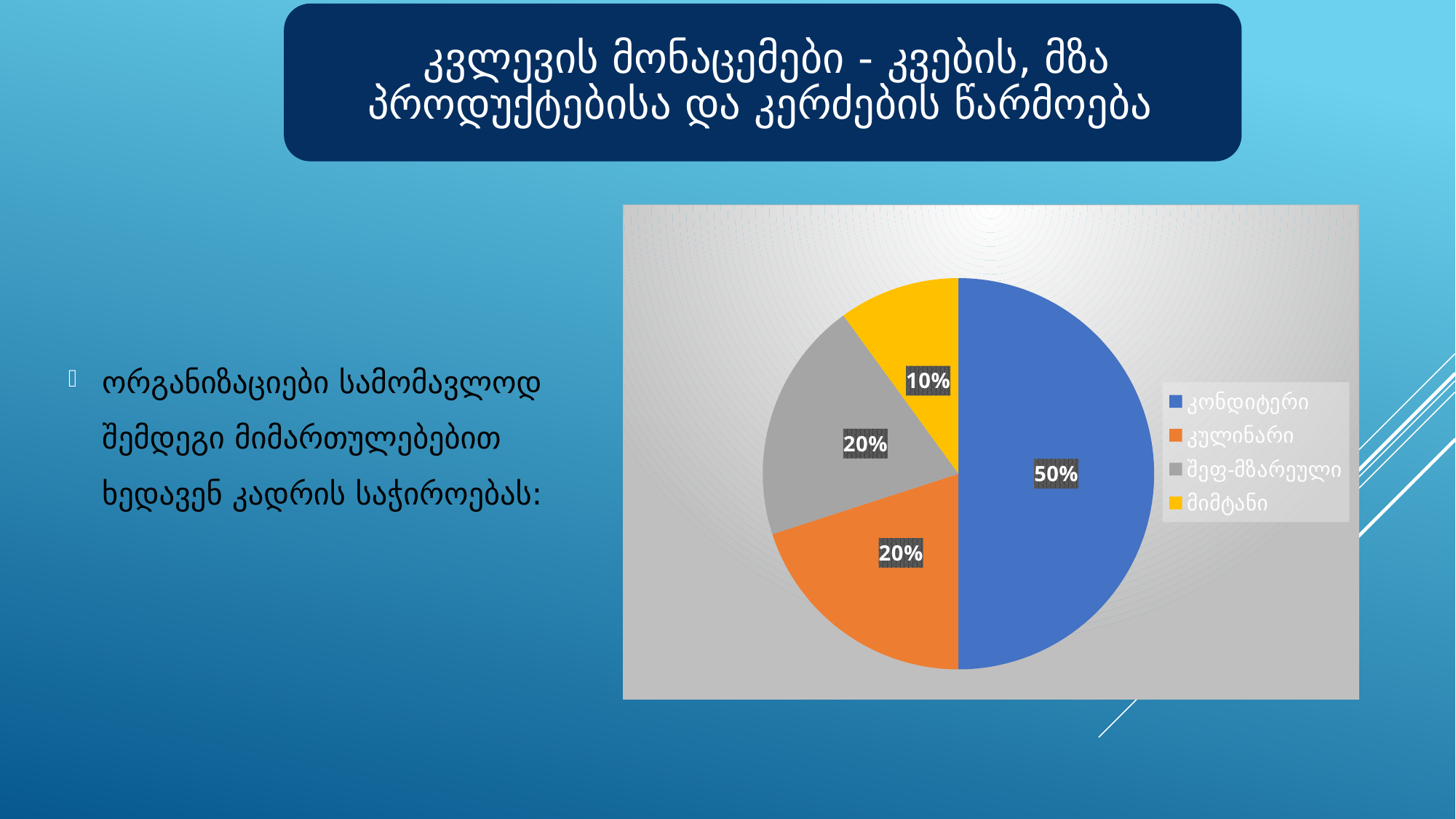
What share of the pie does კულინარი have? 20% What colour is the slice for მიმტანი? yellow Which is larger, the share of კონდიტერი or the share of შეფ-მზარეული? კონდიტერი What share of the pie does კონდიტერი have? 50% What kind of chart is shown on the slide? pie chart Which category has the smallest slice of the pie? მიმტანი How many categories does the legend of the pie chart list? 4 What is the difference between the shares of კონდიტერი and მიმტანი? 40% What is the difference between the shares of კულინარი and მიმტანი? 10% Which category has the largest slice of the pie? კონდიტერი What share of the pie does შეფ-მზარეული have? 20%